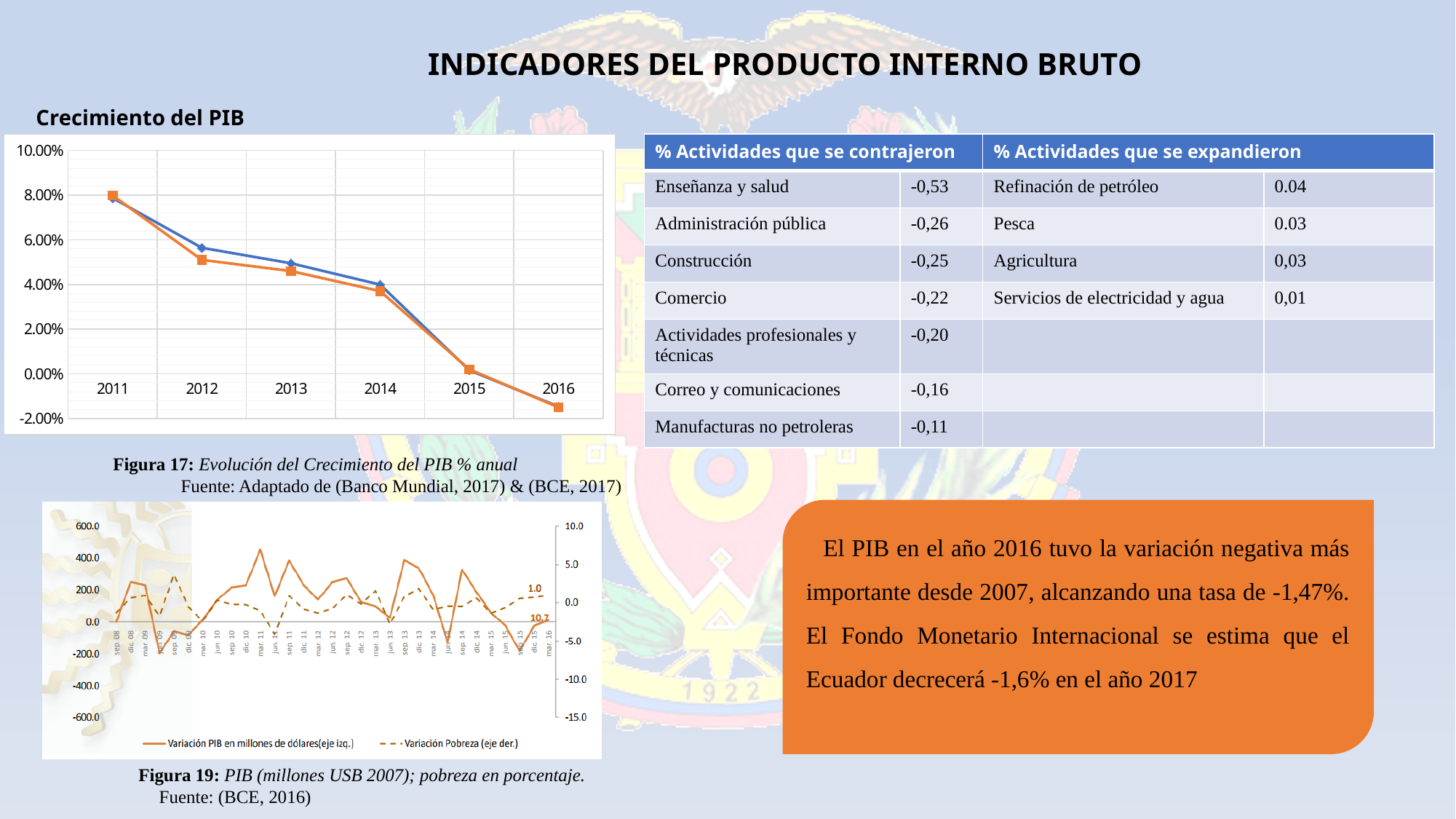
In the 'Crecimiento del PIB' chart, is the value for 2011 greater or less than 6.00%? greater How many series does the legend of the bottom-left chart (Figura 19) list? 2 In the 'Crecimiento del PIB' chart, which year has the larger value, 2012 or 2015? 2012 What kind of chart is the 'Crecimiento del PIB' chart (Figura 17)? line chart In the 'Crecimiento del PIB' chart, which year has the lowest value? 2016 In the 'Crecimiento del PIB' chart, is the value for 2014 greater or less than 6.00%? less In the bottom-left chart (Figura 19), what value is labelled at the end of the dashed 'Variación Pobreza' line? 1.0 In the 'Crecimiento del PIB' chart, which year has the highest value? 2011 In the 'Crecimiento del PIB' chart, is the value for 2016 greater or less than 0.00%? less In the 'Crecimiento del PIB' chart, do the values rise or fall from 2011 to 2016? fall What are the two series named in the legend of the bottom-left chart (Figura 19)? Variación PIB en millones de dólares (eje izq.) and Variación Pobreza (eje der.) How many years are shown on the x axis of the 'Crecimiento del PIB' chart? 6